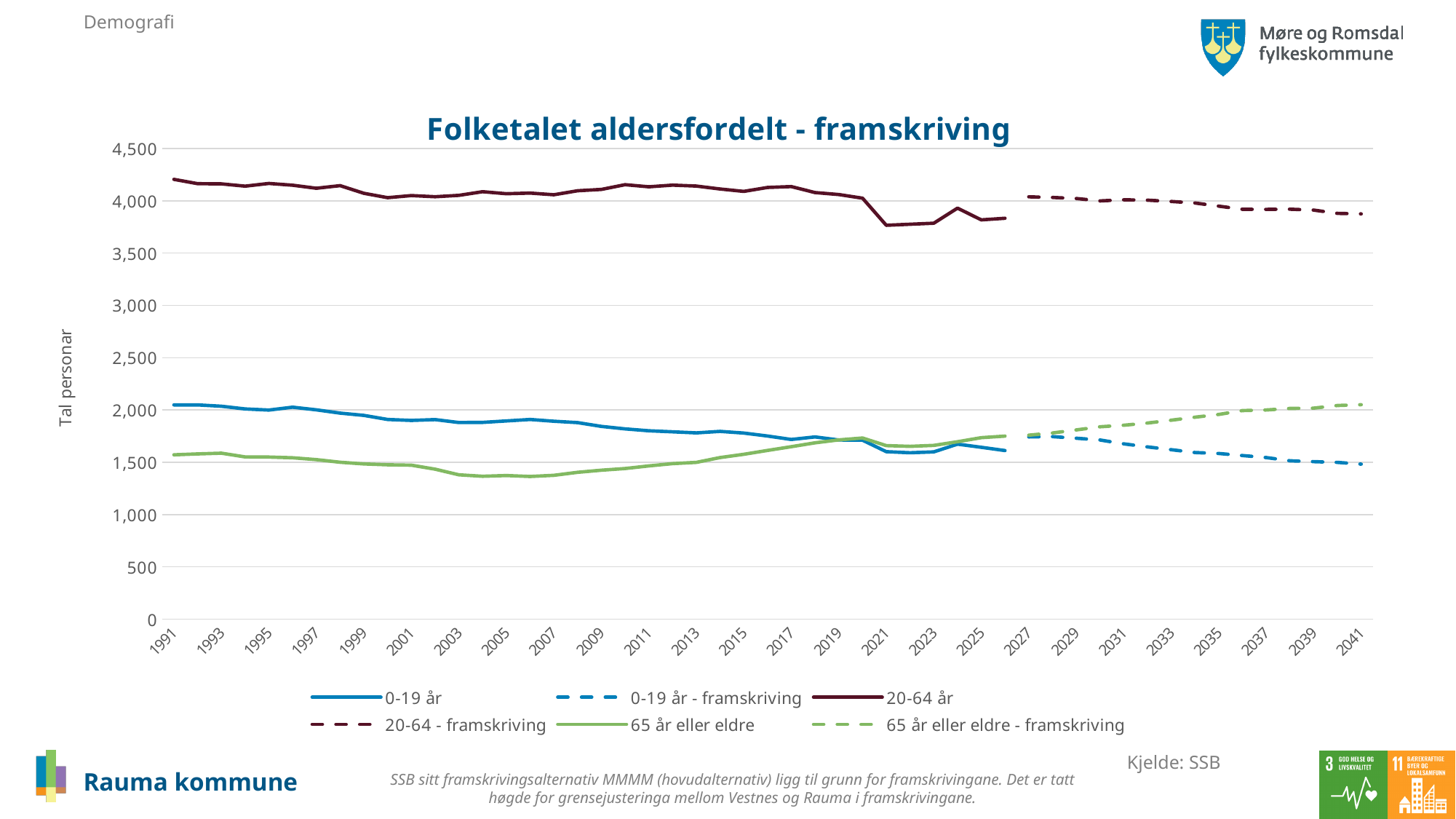
Does the 65 år eller eldre - framskriving series rise or fall from 2027 to 2041? rise Is the value for 0-19 år in 2025 greater or less than 2,000? less What kind of chart is shown on the slide? line chart In 1991, which is larger: 0-19 år or 65 år eller eldre? 0-19 år What is the title of the chart? Folketalet aldersfordelt - framskriving Is the value for 65 år eller eldre in 2005 greater or less than 1,500? less Is the value for 20-64 år in 1991 greater or less than 4,000? greater Does the 0-19 år - framskriving series rise or fall from 2027 to 2041? fall How many series does the legend list? 6 Which series has the highest values across the whole chart? 20-64 år What is the label on the vertical axis? Tal personar